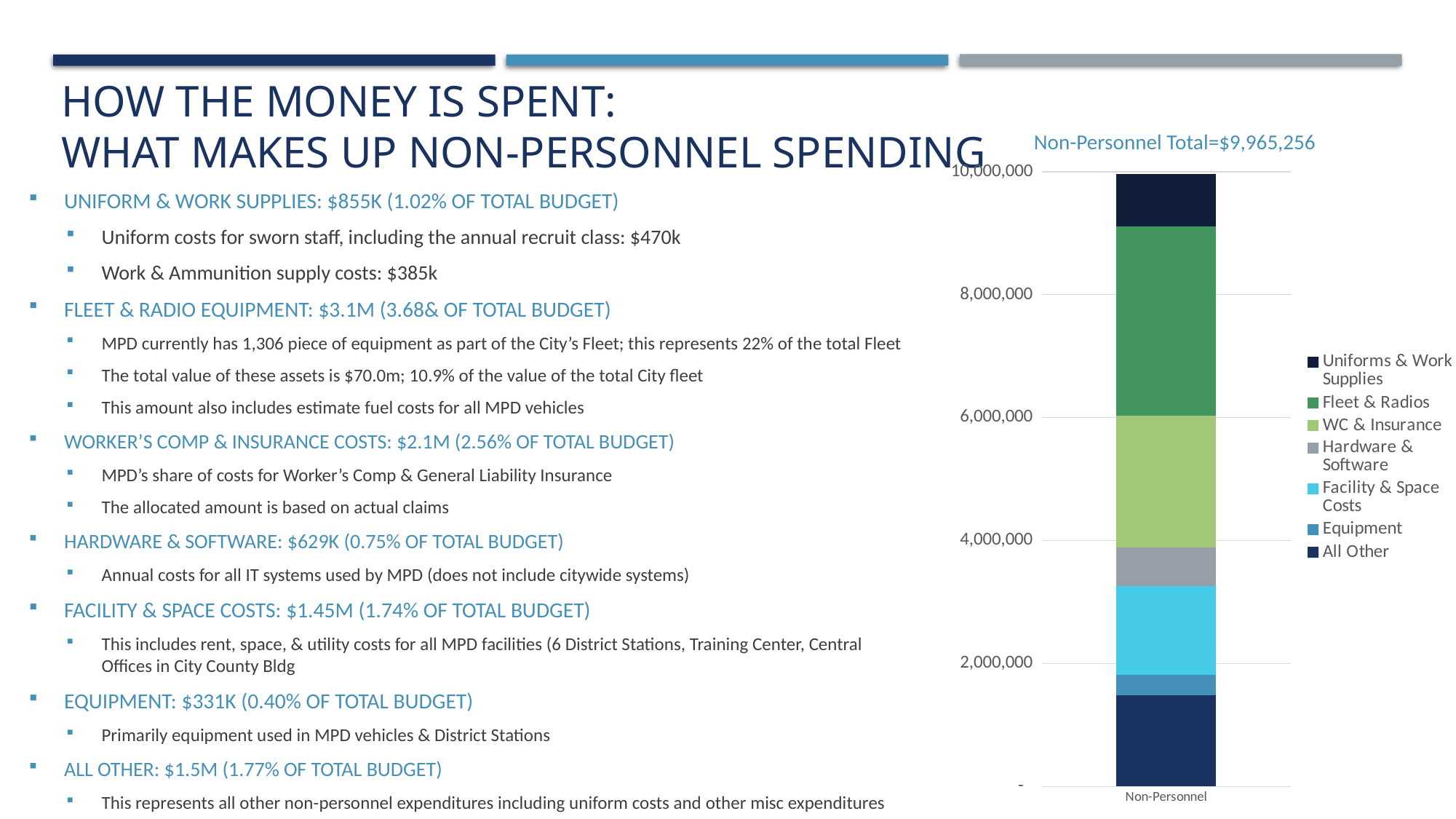
Is the Facility & Space Costs segment of the Non-Personnel bar greater or less than 2,000,000? less How many categories are plotted on the x axis of the chart? 1 Which segment is larger in the Non-Personnel bar: Uniforms & Work Supplies or Equipment? Uniforms & Work Supplies What kind of chart is shown on the slide? stacked bar chart Which series is shown at the top of the Non-Personnel stacked bar? Uniforms & Work Supplies How many series does the chart legend list? 7 Is the total height of the Non-Personnel bar greater or less than 10,000,000? less Is the Fleet & Radios segment of the Non-Personnel bar greater or less than 2,000,000? greater Which series has the smallest segment in the Non-Personnel bar? Equipment What is the total of the Non-Personnel stacked bar, as stated in the chart title? $9,965,256 Which series has the largest segment in the Non-Personnel bar? Fleet & Radios Which segment is larger in the Non-Personnel bar: Fleet & Radios or Facility & Space Costs? Fleet & Radios